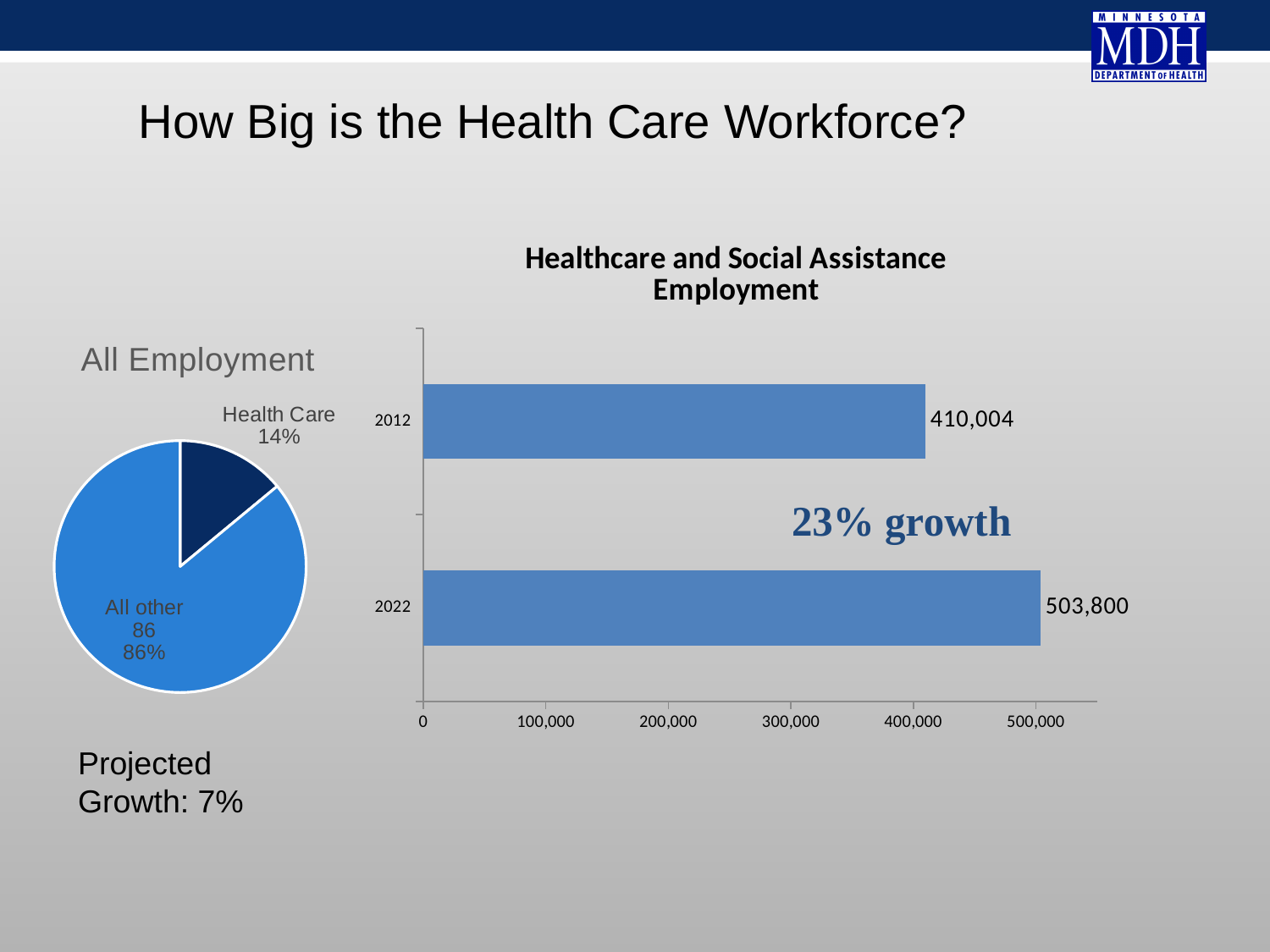
In the 'All Employment' pie chart, what share does Health Care have? 14% What kind of chart is the 'Healthcare and Social Assistance Employment' chart? bar chart In the 'All Employment' pie chart, what share does All other have? 86% In the 'Healthcare and Social Assistance Employment' chart, is the value for 2012 greater or less than 400,000? greater What kind of chart is the 'All Employment' chart? pie chart In the 'Healthcare and Social Assistance Employment' chart, what is the value for 2012? 410,004 In the 'Healthcare and Social Assistance Employment' chart, which year has the lower employment value? 2012 In the 'Healthcare and Social Assistance Employment' chart, what is the difference between the 2022 and 2012 values? 93,796 In the 'Healthcare and Social Assistance Employment' chart, what growth percentage is annotated between the two bars? 23% growth In the 'Healthcare and Social Assistance Employment' chart, which year has the higher employment value? 2022 In the 'Healthcare and Social Assistance Employment' chart, what is the value for 2022? 503,800 In the 'Healthcare and Social Assistance Employment' chart, how many bars are plotted? 2